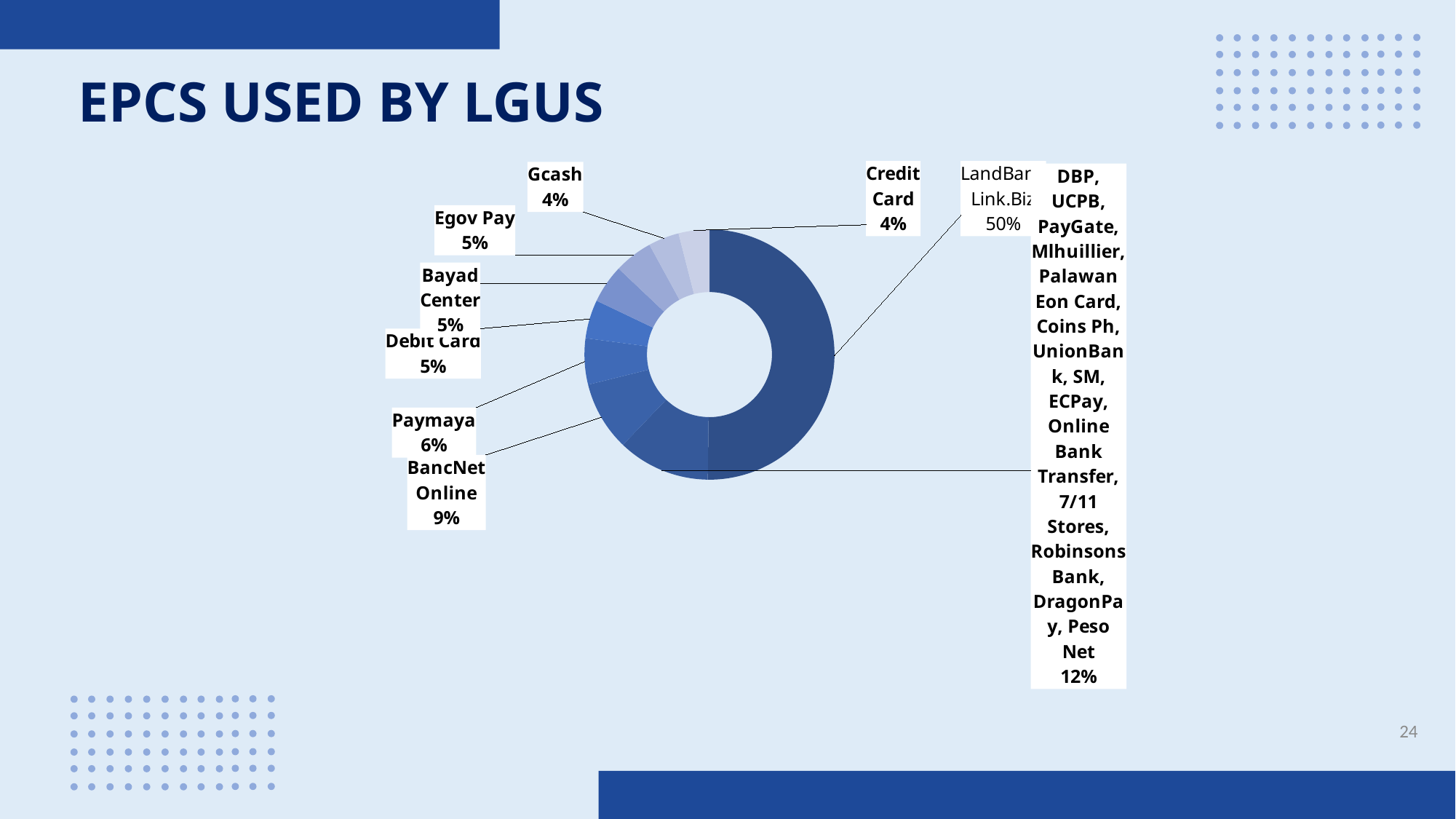
What percentage is shown for Credit Card? 4% What kind of chart is shown on the slide? Pie (donut) chart What percentage is shown for BancNet Online? 9% How many slices does the pie chart have? 9 Which category has the largest share of the pie? LandBank Link.Biz What share of the pie does LandBank Link.Biz hold? 50% What percentage is shown for Paymaya? 6% What percentage is shown for Gcash? 4% What is the difference in percentage points between LandBank Link.Biz and BancNet Online? 41 What is the title of the chart on the slide? EPCS USED BY LGUS What percentage is shown for the slice grouping DBP, UCPB, PayGate and other providers? 12% Which is larger, the share for Paymaya or the share for Egov Pay? Paymaya